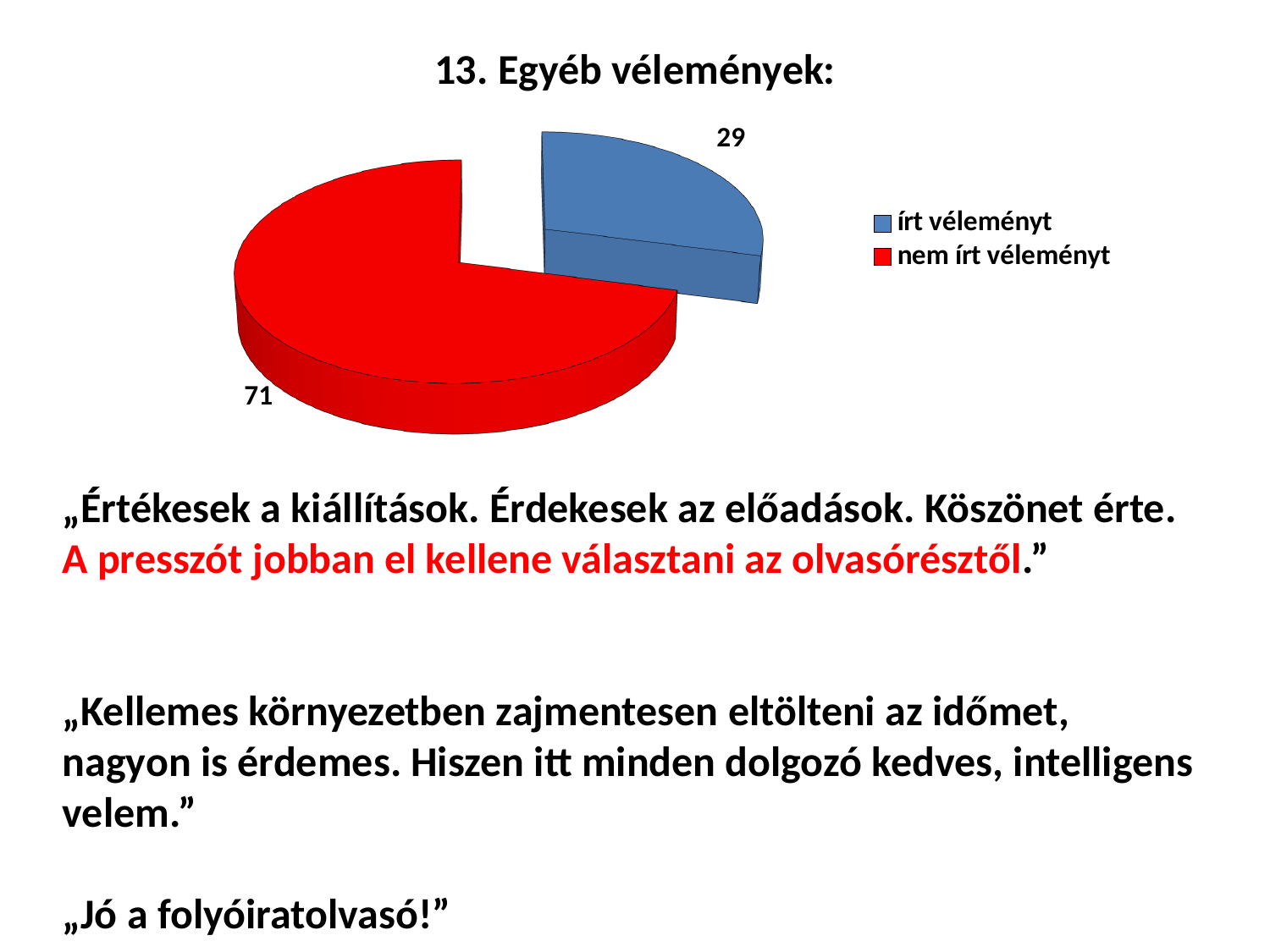
What share of the pie does "nem írt véleményt" represent? 71% Which category has the smallest slice of the pie? írt véleményt Which category has the largest slice of the pie? nem írt véleményt Which is larger, the value for "írt véleményt" or the value for "nem írt véleményt"? nem írt véleményt What type of chart is shown on the slide? pie chart How many slices does the pie chart have? 2 What is the value for "írt véleményt"? 29 What is the total of the two values shown in the pie chart? 100 What is the value for "nem írt véleményt"? 71 What colour is the slice for "írt véleményt"? blue What is the difference between the values for "nem írt véleményt" and "írt véleményt"? 42 How many entries does the legend list? 2